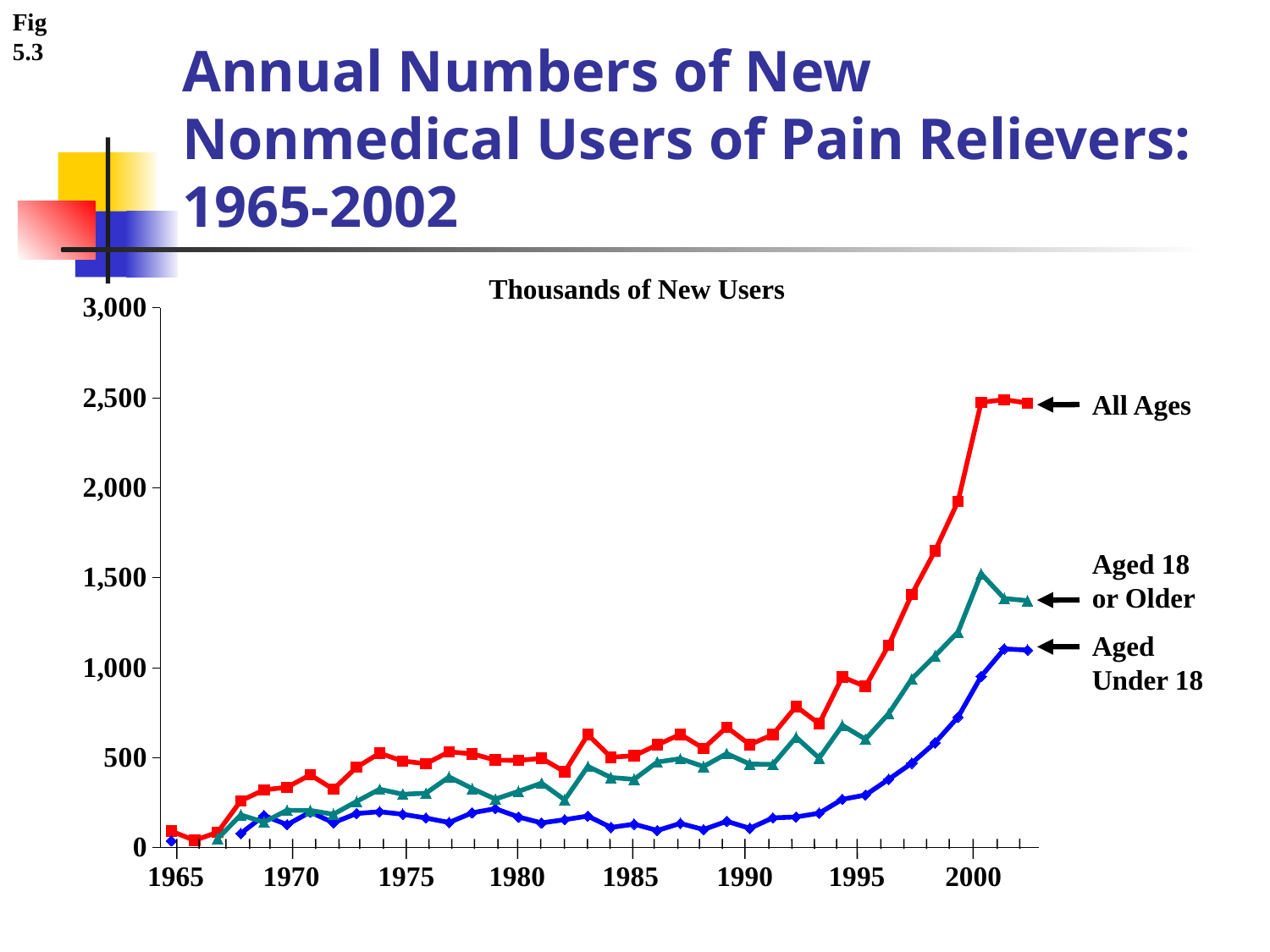
What unit label is shown above the y axis of the chart? Thousands of New Users How many series are plotted on the chart? 3 Which series has the lowest values across the chart? Aged Under 18 Is the value for Aged Under 18 in 1990 greater or less than 500? less What kind of chart is shown on the slide? line chart Is the value for Aged 18 or Older in 2000 greater or less than 1,000? greater In 1995, which is larger: the value for Aged 18 or Older or the value for Aged Under 18? Aged 18 or Older What is the title of the chart? Annual Numbers of New Nonmedical Users of Pain Relievers: 1965-2002 Do the values for All Ages rise or fall between 1995 and 2000? rise Is the value for All Ages in 1975 greater or less than 1,000? less Which series has the highest values across the chart? All Ages